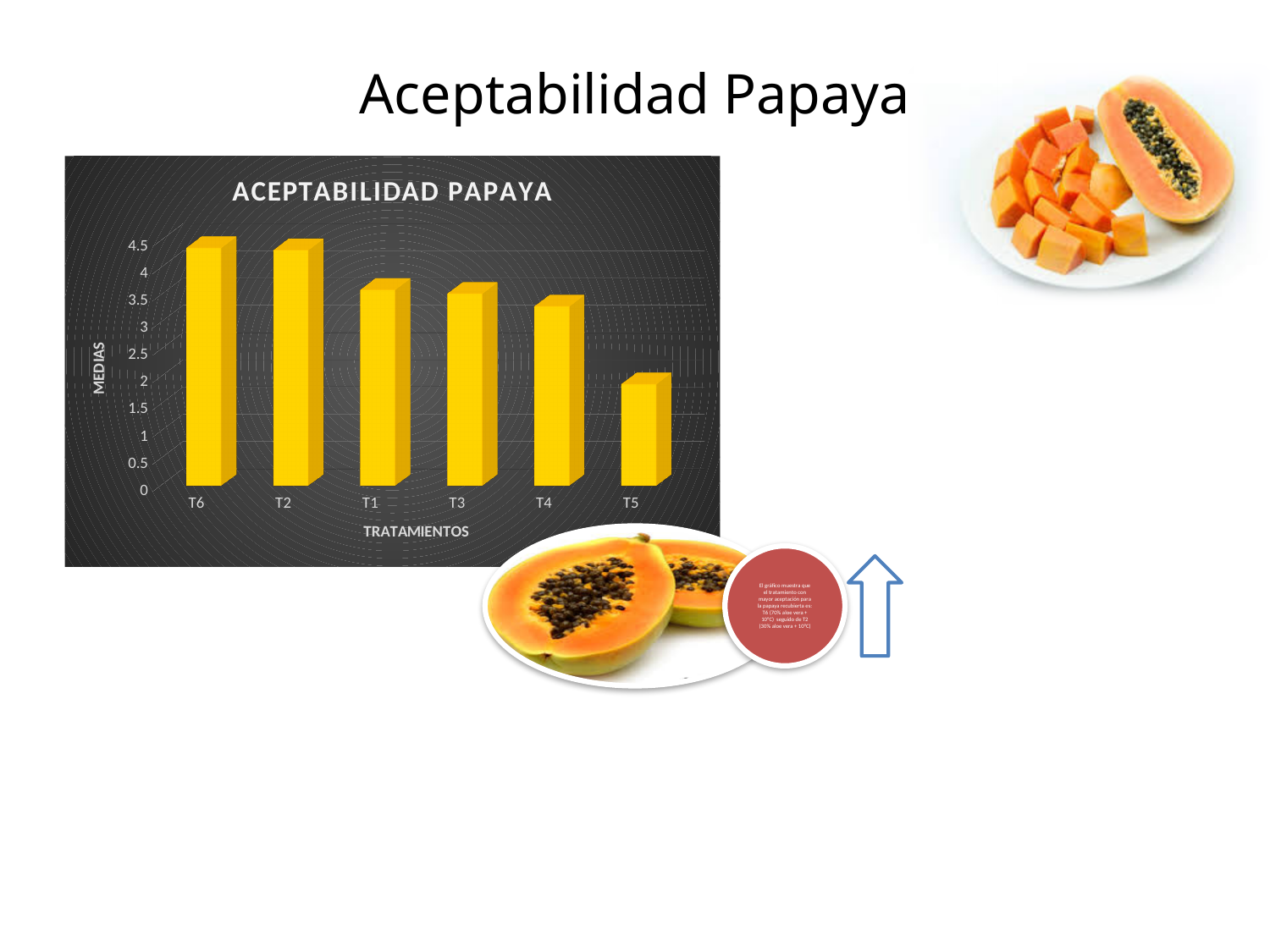
What is the label of the vertical axis? MEDIAS Is the value for T5 greater or less than 3? less Which treatment has the lowest value? T5 Is the value for T1 greater or less than 3? greater Which has the larger value, T2 or T4? T2 What kind of chart is shown on the slide? bar chart Do the values generally rise or fall moving from left to right along the x axis? fall Is the value for T6 greater or less than 4? greater Which has the larger value, T6 or T5? T6 How many treatments (categories) are plotted on the x axis? 6 What is the title of the chart? ACEPTABILIDAD PAPAYA